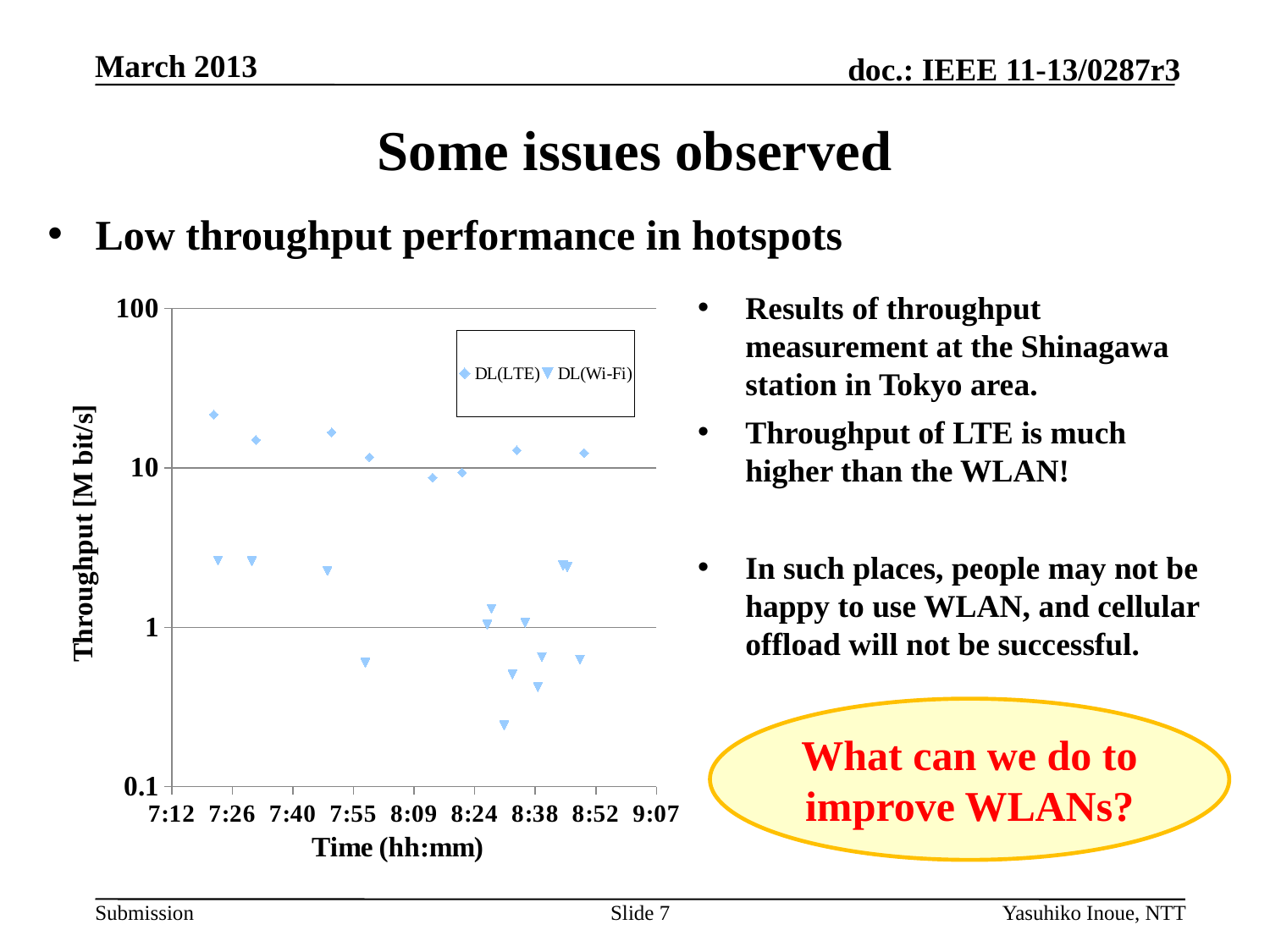
Which series contains the lowest throughput point in the chart? DL(Wi-Fi) Is the earliest DL(LTE) point (just after 7:12) greater or less than 10 M bit/s? greater What kind of chart is shown on the slide? Scatter chart Which series contains the single highest throughput point in the chart? DL(LTE) How many series does the chart legend list? 2 Are all DL(LTE) points greater or less than 1 M bit/s? greater Is the lowest DL(Wi-Fi) point greater or less than 1 M bit/s? less What is the title of the chart's vertical axis? Throughput [M bit/s] What are the two series named in the chart legend? DL(LTE) and DL(Wi-Fi) How many DL(LTE) data points are plotted in the chart? 8 Which series has the higher throughput values overall, DL(LTE) or DL(Wi-Fi)? DL(LTE)